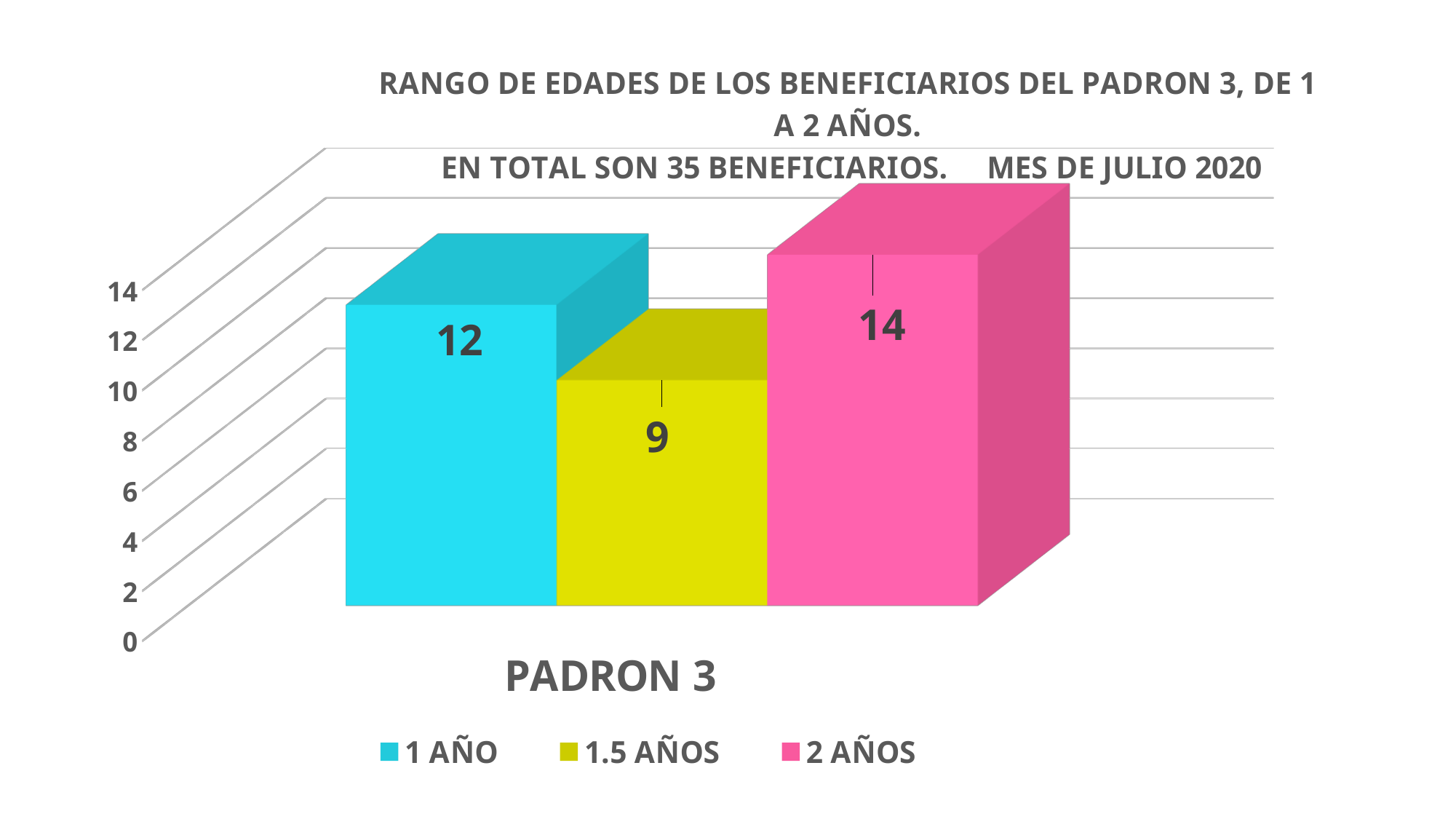
What is the difference between the 1 AÑO value and the 1.5 AÑOS value? 3 Which is larger, the value for 1 AÑO or the value for 2 AÑOS? 2 AÑOS What is the value for the 1 AÑO series? 12 What is the value for the 1.5 AÑOS series? 9 What kind of chart is shown on the slide? bar chart What is the category label shown on the x axis? PADRON 3 Which series has the lowest value? 1.5 AÑOS Is the value for 1.5 AÑOS greater or less than 10? less What is the difference between the 2 AÑOS value and the 1.5 AÑOS value? 5 How many series does the legend list? 3 What is the value for the 2 AÑOS series? 14 Which series has the highest value? 2 AÑOS